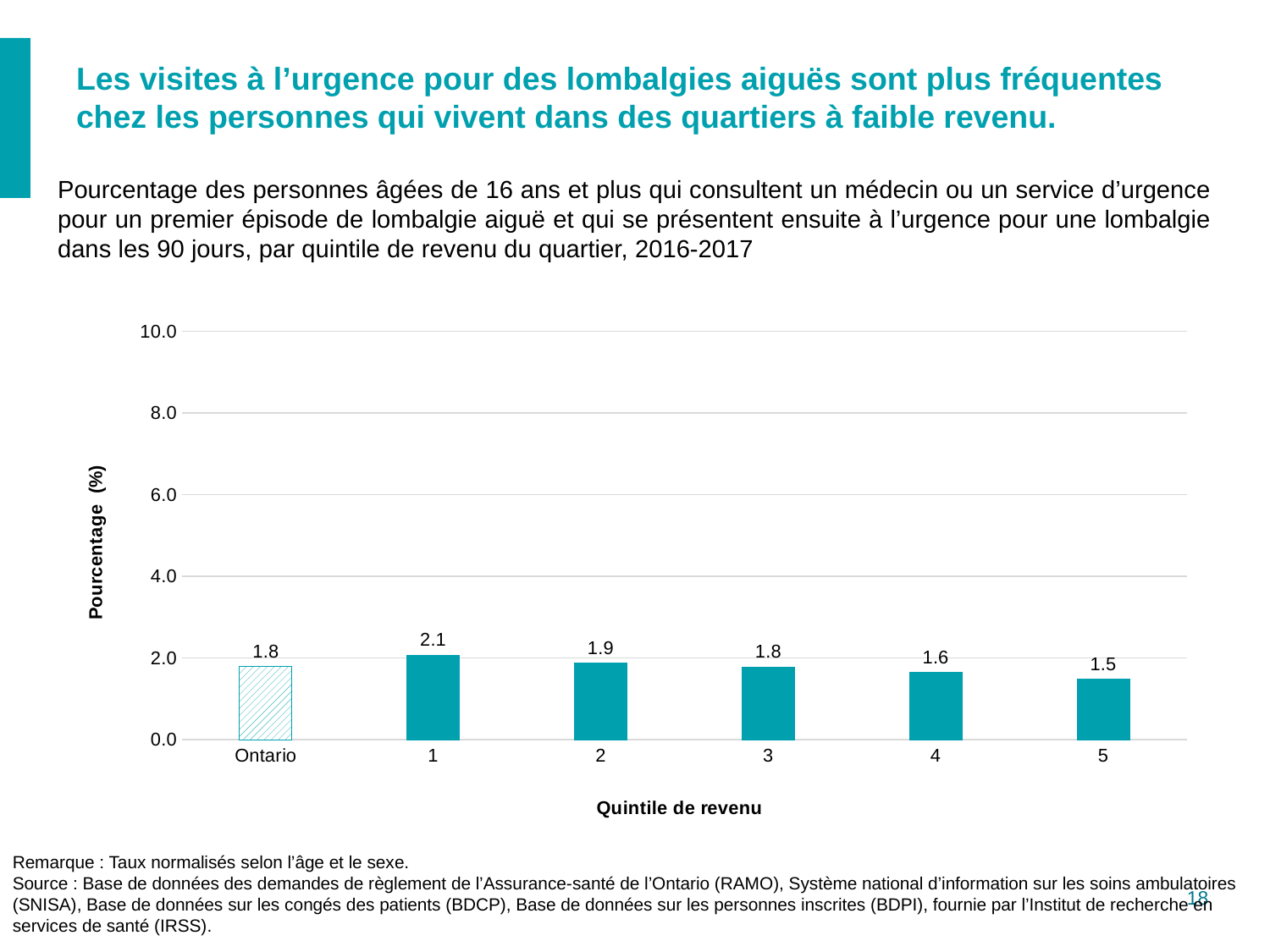
What is the value for income quintile 4? 1.6 Which is larger, the value for quintile 2 or the value for quintile 4? quintile 2 What is the value for income quintile 1? 2.1 Which income quintile has the highest value? 1 Is the value for quintile 1 greater or less than 4.0? less What is the value for Ontario? 1.8 What kind of chart is shown on the slide? bar chart Which income quintile has the lowest value? 5 How many bars are shown in the chart? 6 What is the value for income quintile 5? 1.5 Do the values rise or fall from quintile 1 to quintile 5? fall What is the difference between the values for quintile 1 and quintile 5? 0.6